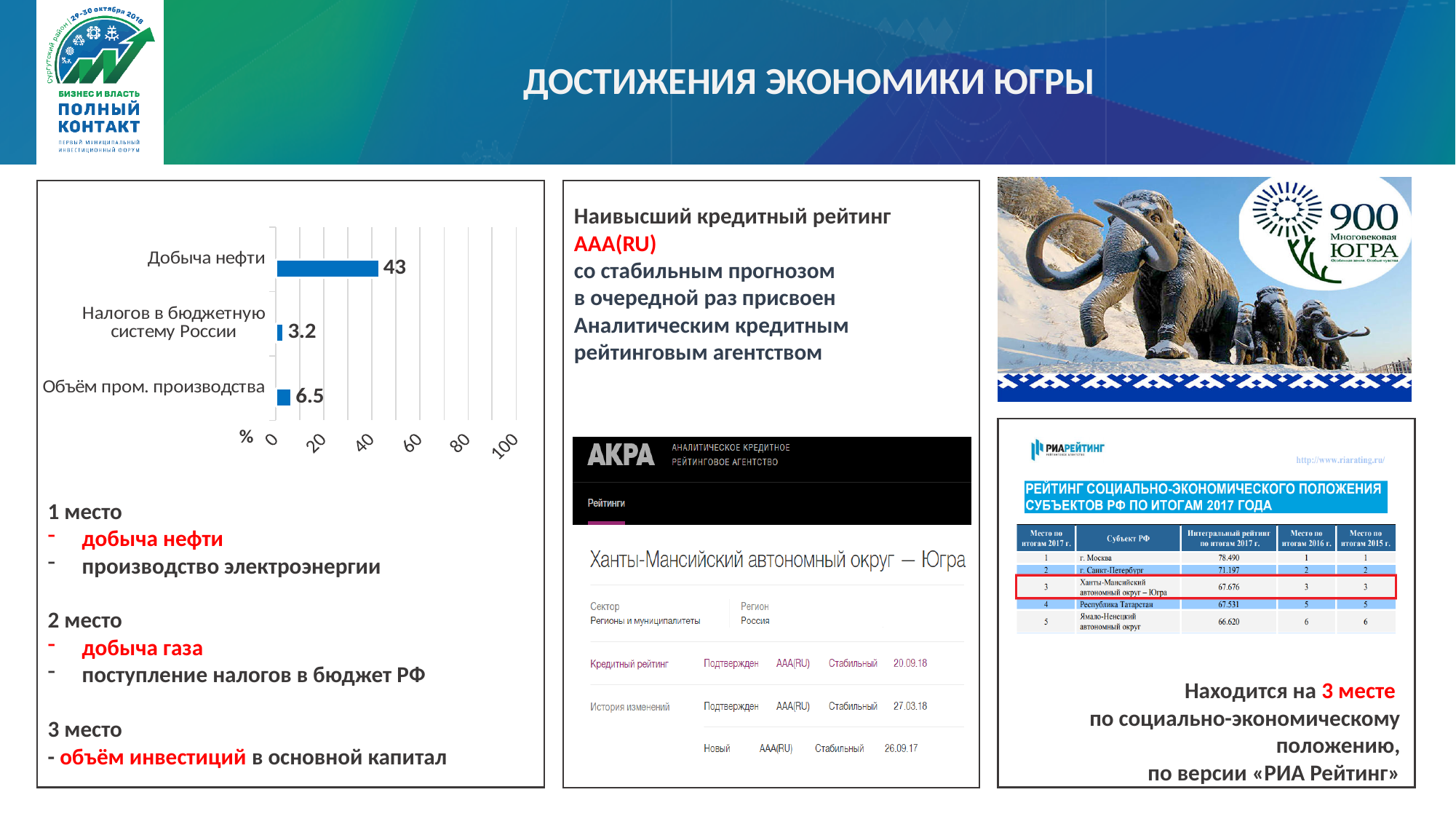
What value does the chart show for Добыча нефти? 43 Which is larger: the value for Объём пром. производства or the value for Налогов в бюджетную систему России? Объём пром. производства Is the value for Добыча нефти greater or less than 40? greater What is the maximum value shown on the chart's value axis? 100 Which category has the highest value in the chart? Добыча нефти What is the difference between the values for Добыча нефти and Объём пром. производства? 36.5 How many categories are shown in the chart? 3 Which category has the lowest value in the chart? Налогов в бюджетную систему России What kind of chart is shown on the slide? bar chart What is the difference between the values for Объём пром. производства and Налогов в бюджетную систему России? 3.3 What value does the chart show for Налогов в бюджетную систему России? 3.2 What value does the chart show for Объём пром. производства? 6.5